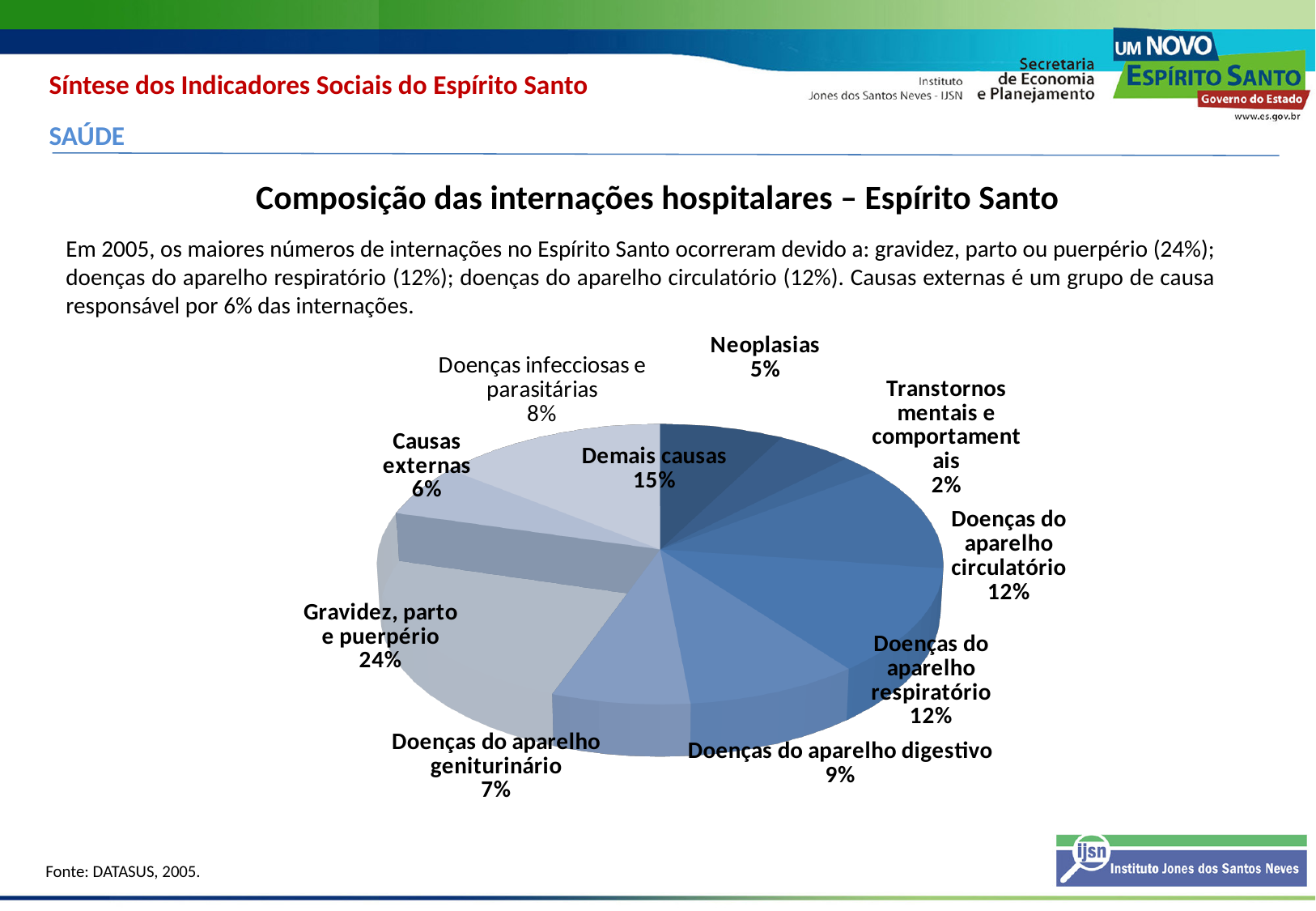
Which is larger: the share for Doenças infecciosas e parasitárias or the share for Doenças do aparelho geniturinário? Doenças infecciosas e parasitárias What is the difference in percentage points between Gravidez, parto e puerpério and Demais causas? 9 What percentage is shown for Doenças do aparelho digestivo? 9% What share of hospital admissions is attributed to Gravidez, parto e puerpério? 24% Which category has the smallest share of the pie? Transtornos mentais e comportamentais What percentage does the Neoplasias slice represent? 5% What share is shown for Demais causas? 15% What type of chart is shown on the slide? Pie chart What is the title of the chart on the slide? Composição das internações hospitalares – Espírito Santo Which category has the largest share of the pie? Gravidez, parto e puerpério How many slices does the pie chart have? 10 What is the combined share of Doenças do aparelho circulatório and Doenças do aparelho respiratório? 24%